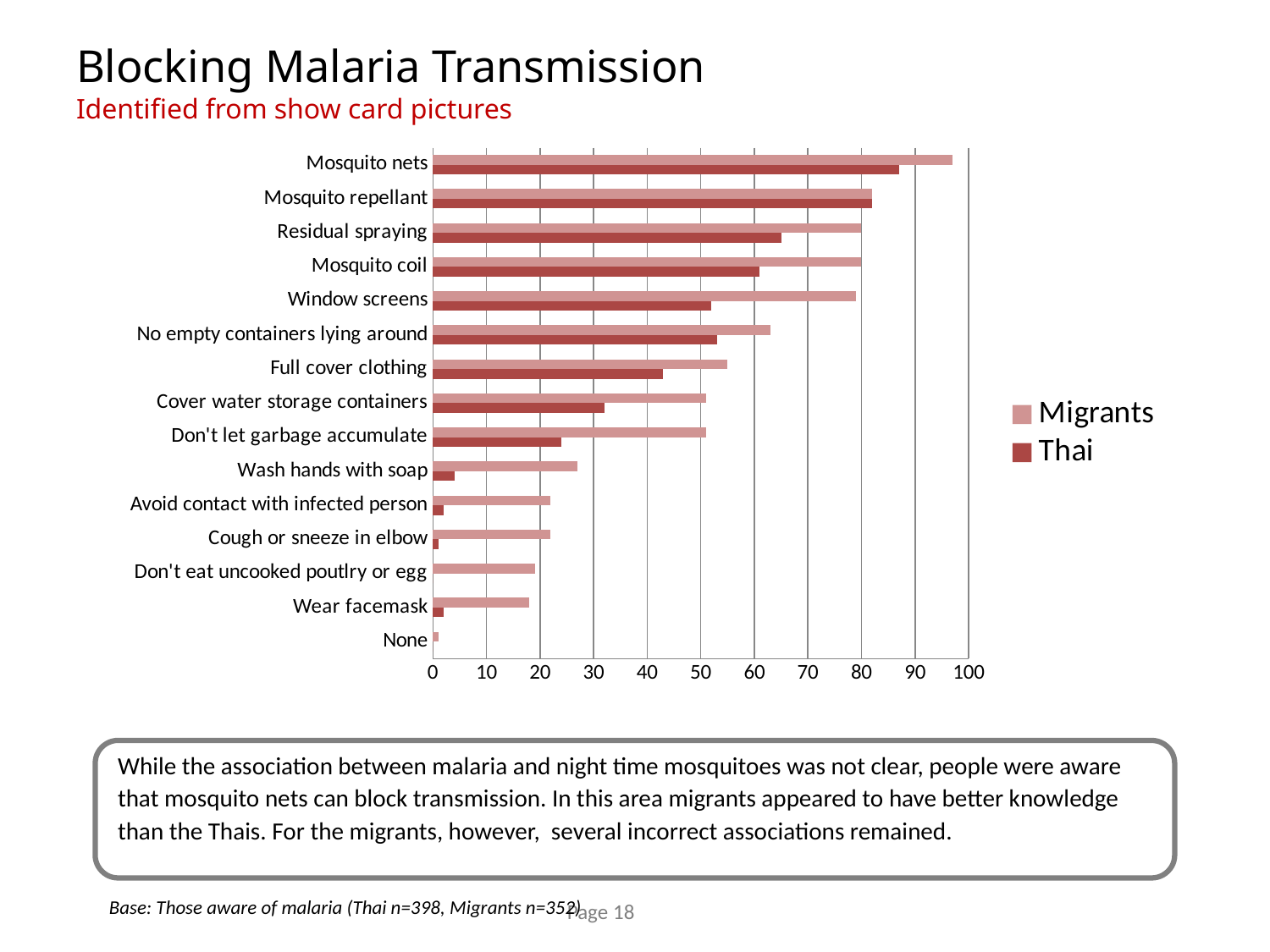
Is the Migrants value for Wash hands with soap greater or less than 20? greater Is the Thai value for Don't let garbage accumulate greater or less than 30? less How many series does the legend list? 2 Which category has the lowest value for Migrants? None Which series is shown in the darker red colour? Thai How many categories are shown on the chart? 15 Is the Thai value for Residual spraying greater or less than 60? greater Which category has the highest value for Migrants? Mosquito nets What kind of chart is shown on the slide? bar chart For Window screens, which series has the larger value, Migrants or Thai? Migrants Which category has the highest value for Thai? Mosquito nets